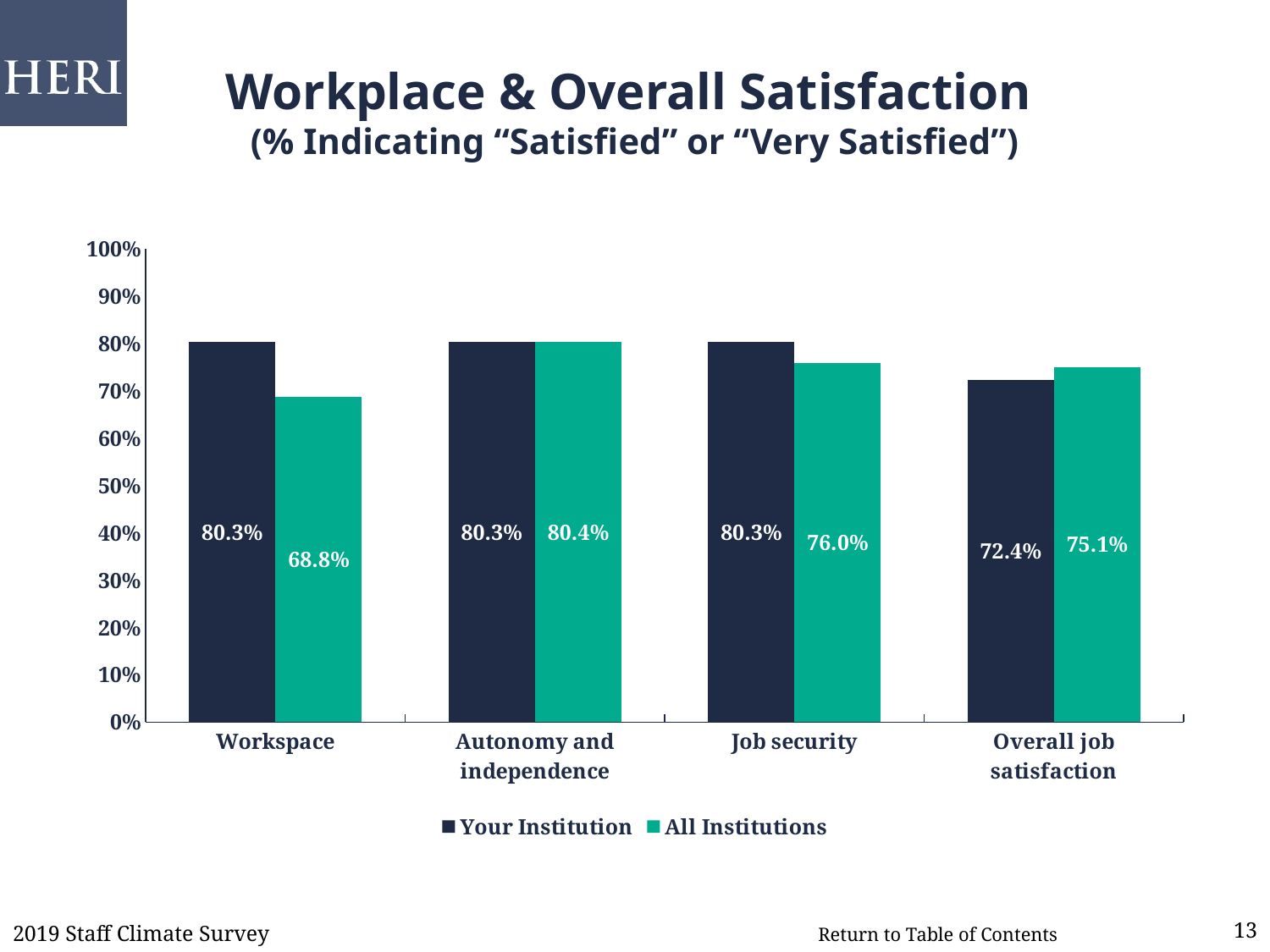
What is the value for All Institutions for Job security? 76.0% Which category has the lowest value for All Institutions? Workspace How many series does the legend list? 2 How many categories are shown on the x axis? 4 What kind of chart is shown on the slide? Bar chart For Overall job satisfaction, which is larger: Your Institution or All Institutions? All Institutions What is the value for Your Institution for Workspace? 80.3% What is the value for All Institutions for Workspace? 68.8% What is the value for Your Institution for Overall job satisfaction? 72.4% What is the difference between Your Institution and All Institutions for Workspace? 11.5% Is the value for All Institutions for Job security greater or less than 70%? greater Which category has the lowest value for Your Institution? Overall job satisfaction